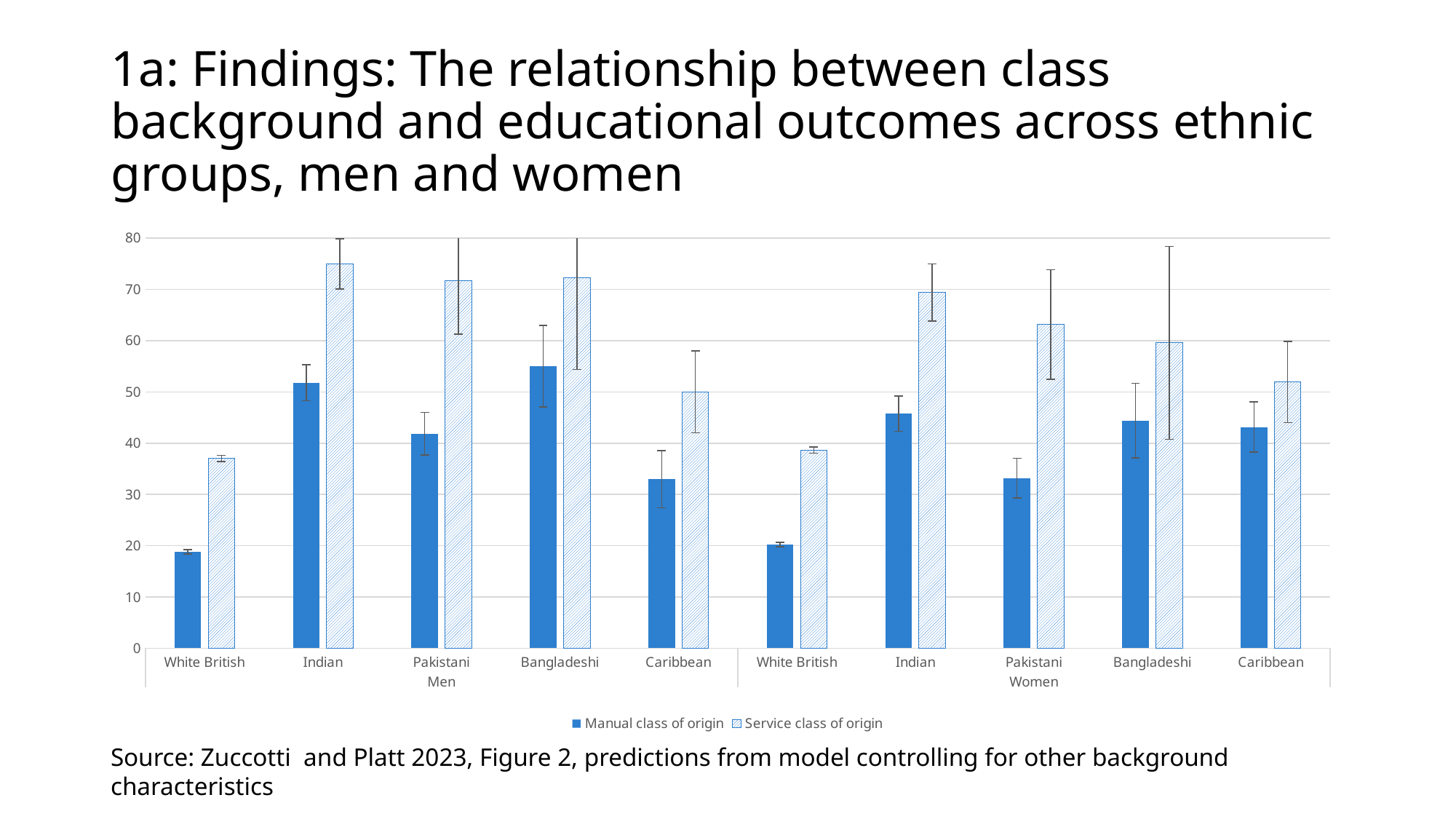
Is the Service class of origin value for Caribbean men greater or less than 40? greater Among women, which ethnic group has the highest Service class of origin value? Indian What are the two series named in the legend? Manual class of origin; Service class of origin What kind of chart is shown on the slide? bar chart Is the Service class of origin value for Indian men greater or less than 70? greater Among women, which ethnic group has the lowest Manual class of origin value? White British Is the Manual class of origin value for White British men greater or less than 30? less For Bangladeshi women, which is larger: the Manual class of origin value or the Service class of origin value? Service class of origin How many ethnic-group categories are plotted along the x axis in total (across Men and Women)? 10 How many series does the legend list? 2 Which is larger: the Manual class of origin value for Indian men or for Caribbean men? Indian men